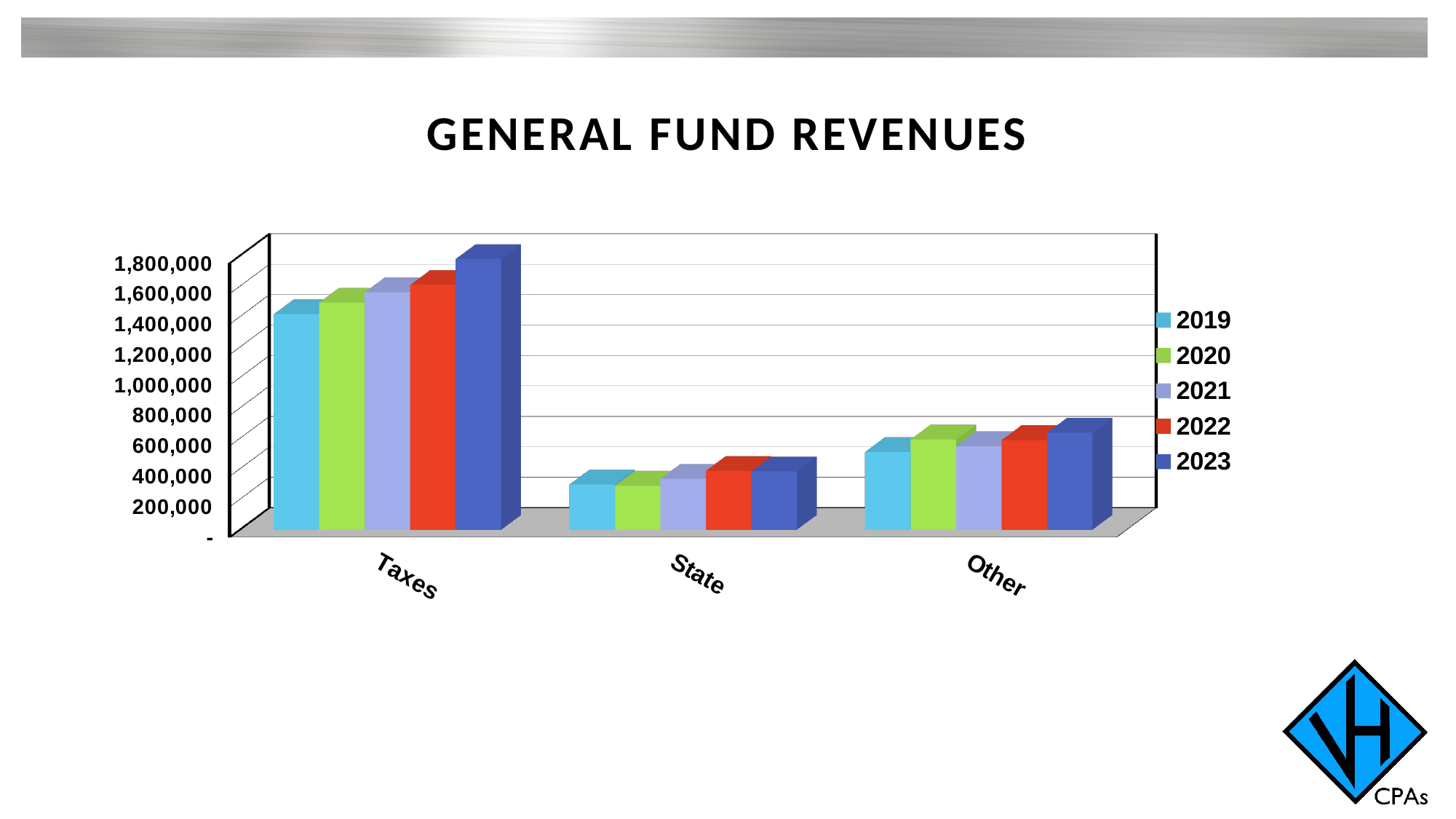
Within the Taxes category, which year has the tallest bar? 2023 How many series does the legend list? 5 Do the Taxes bars rise or fall from 2019 to 2023? Rise Which category has the lowest revenue in 2019? State How many categories are shown on the x axis? 3 Is the value for State in 2019 greater or less than 600,000? less Which category has the highest revenue in 2023? Taxes Is the value for Taxes in 2023 greater or less than 1,600,000? greater Which is larger, the 2019 value for Other or the 2019 value for State? Other What kind of chart is shown on the slide? Bar chart Within the Taxes category, which year has the shortest bar? 2019 What is the title of the chart? GENERAL FUND REVENUES